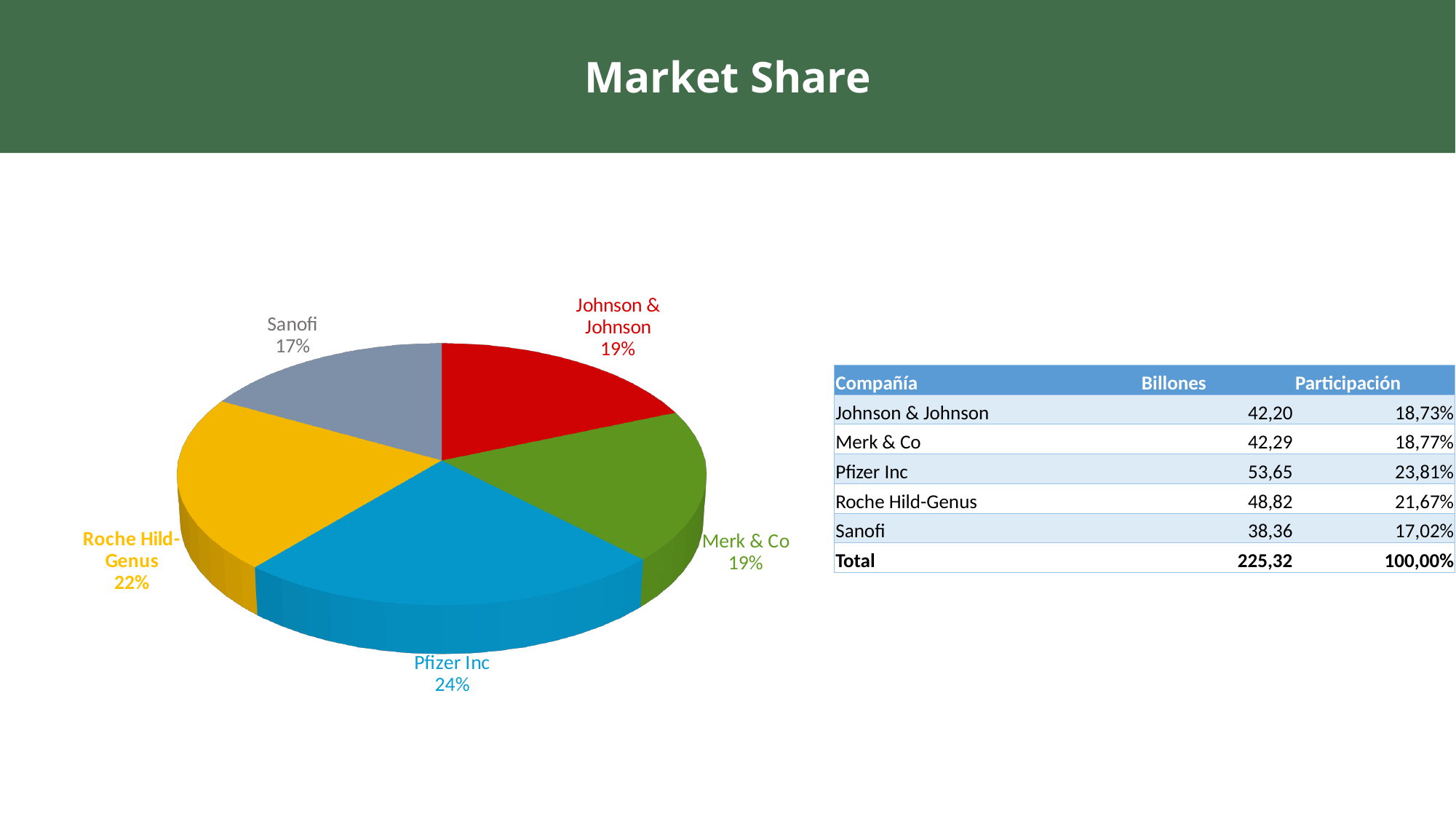
Which slice is larger, Pfizer Inc or Roche Hild-Genus? Pfizer Inc What percentage is shown for Merk & Co in the pie chart? 19% What percentage is shown for Johnson & Johnson in the pie chart? 19% Which company has the largest slice of the pie chart? Pfizer Inc What percentage is shown for Roche Hild-Genus in the pie chart? 22% What is the difference in percentage points between the Pfizer Inc slice and the Sanofi slice? 7 percentage points What share of the pie does Pfizer Inc hold? 24% How many slices does the pie chart have? 5 What share of the pie does Sanofi hold? 17% Which company has the smallest slice of the pie chart? Sanofi What kind of chart is shown on the slide? pie chart What is the title of the slide containing the pie chart? Market Share